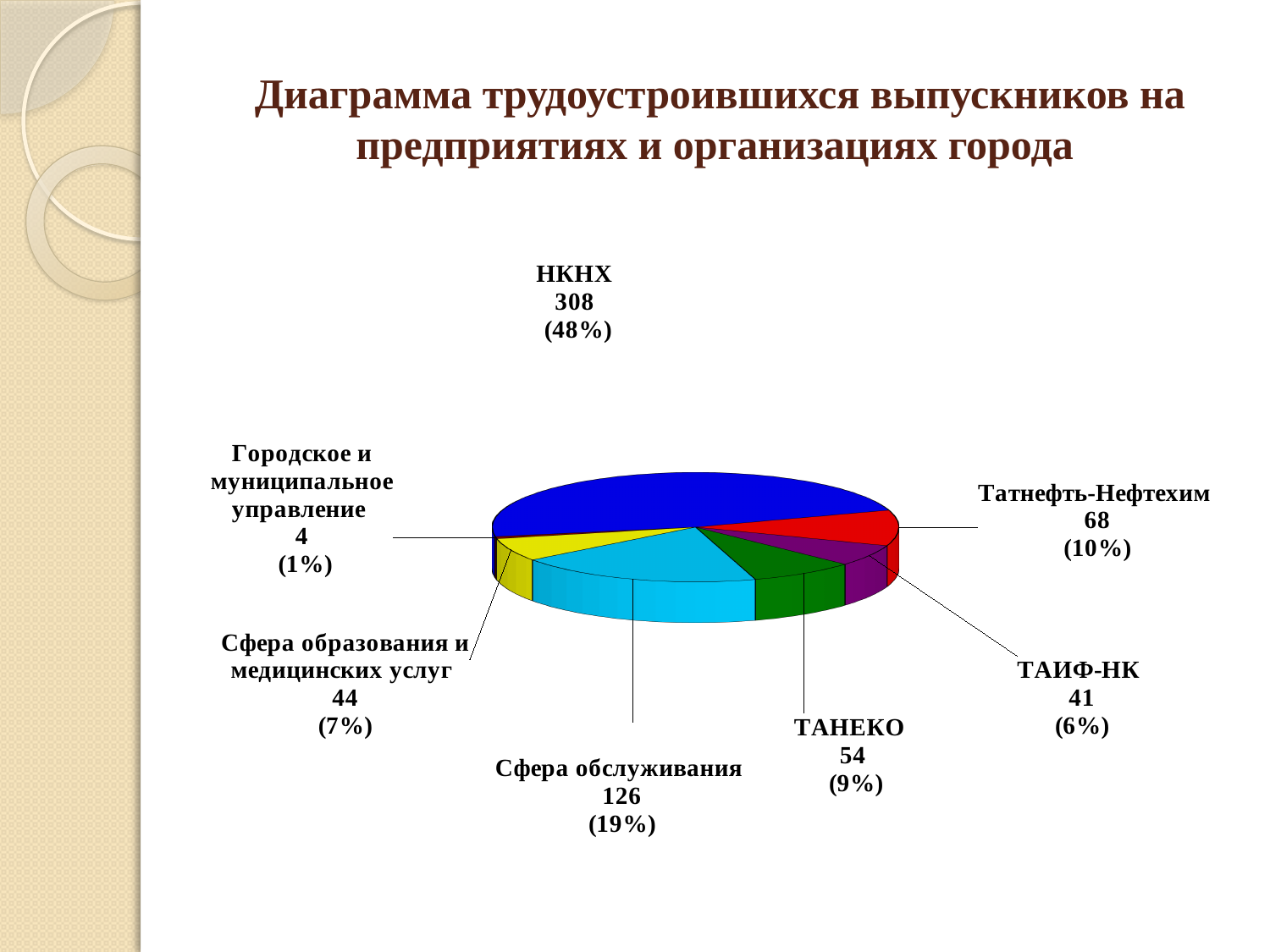
What colour is the НКНХ slice of the pie? Blue How many slices does the pie chart have? 7 What percentage share is shown for ТАИФ-НК? 6% How many graduates were employed at НКНХ? 308 What share of the pie does Сфера обслуживания represent? 19% What is the value shown for Городское и муниципальное управление? 4 Which is larger: the value for ТАНЕКО or the value for Сфера образования и медицинских услуг? ТАНЕКО Which category has the largest slice of the pie? НКНХ What type of chart is shown on the slide? Pie chart Which category has the smallest slice of the pie? Городское и муниципальное управление What is the difference between the number of graduates at Татнефть-Нефтехим and at ТАИФ-НК? 27 How many graduates were employed at ТАНЕКО? 54